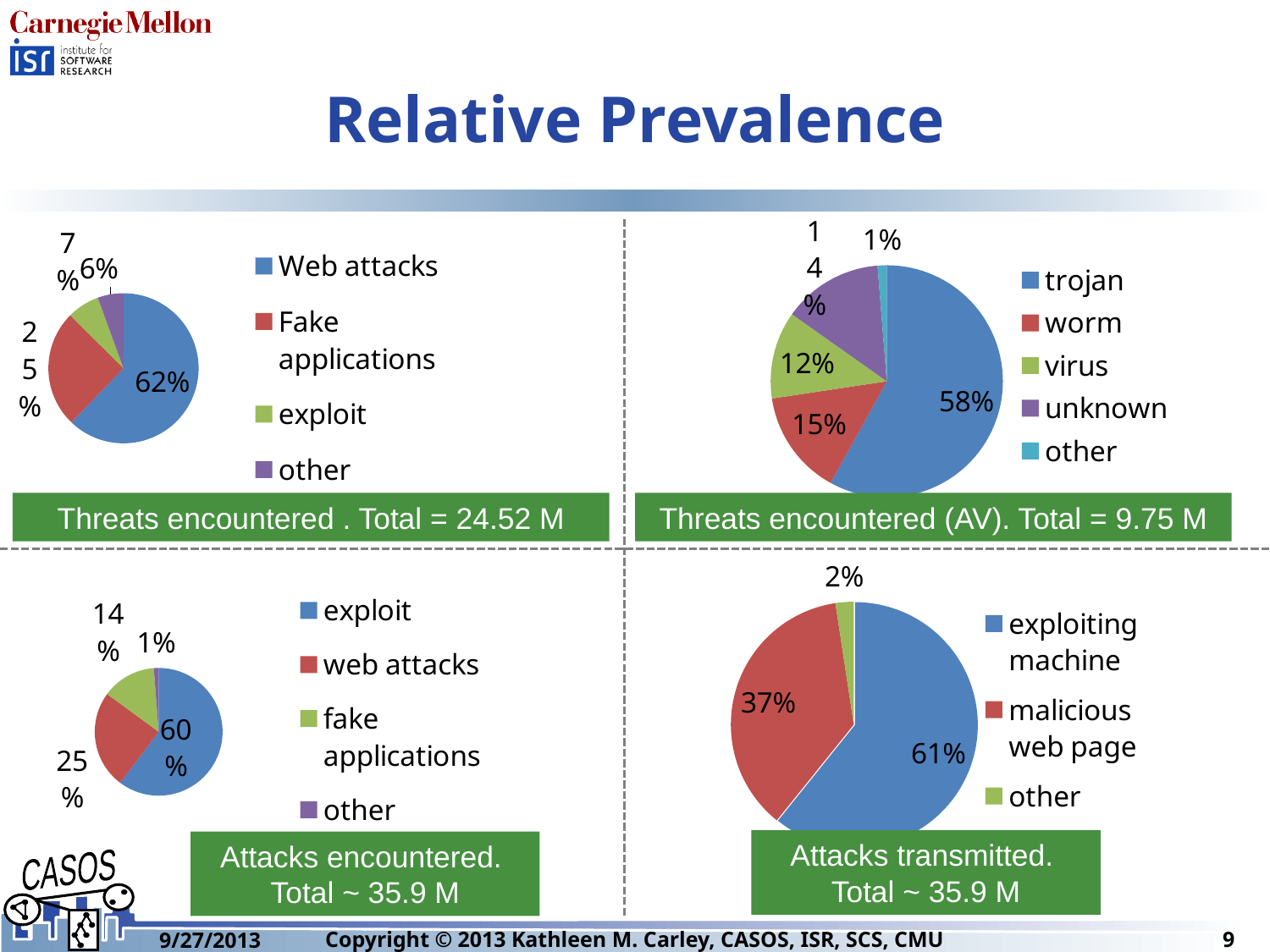
In the 'Threats encountered (AV)' pie chart, how many categories does the legend list? 5 In the 'Attacks transmitted' pie chart, which category has the largest share? exploiting machine In the 'Threats encountered (AV)' pie chart, which category has the smallest share? other In the 'Threats encountered (AV)' pie chart, what share is labelled for trojan? 58% In the 'Threats encountered . Total = 24.52 M' pie chart, what share is labelled for Web attacks? 62% In the 'Threats encountered . Total = 24.52 M' pie chart, what share is labelled for Fake applications? 25% In the 'Attacks encountered' pie chart, what share is labelled for exploit? 60% In the 'Attacks encountered' pie chart, what is the difference between the web attacks share and the fake applications share? 11% What kind of chart is used in the 'Attacks transmitted' panel? pie chart In the 'Attacks transmitted' pie chart, what share is labelled for malicious web page? 37% What total is stated in the caption of the 'Threats encountered (AV)' chart? 9.75 M In the 'Threats encountered (AV)' pie chart, what share is labelled for worm? 15%